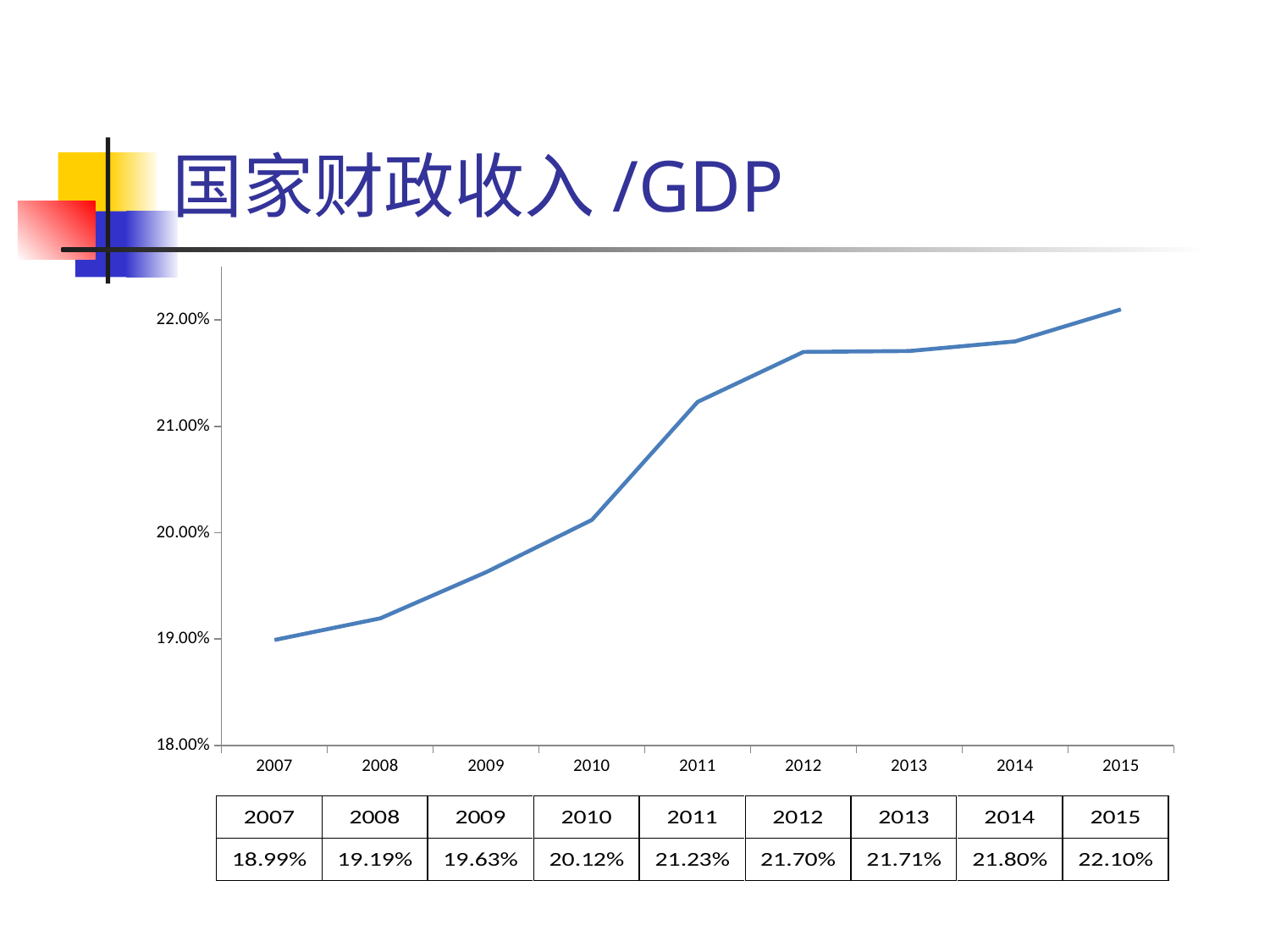
Is the value for 2012 greater or less than 21.00%? greater Do the values rise or fall from 2007 to 2015? rise What is the difference between the values for 2011 and 2010? 1.11% What is the value for 2015? 22.10% Which is larger, the value for 2009 or the value for 2010? 2010 How many years are plotted on the chart? 9 Which year has the lowest value? 2007 What is the value for 2011? 21.23% Which year has the highest value? 2015 What kind of chart is shown on the slide? line chart What is the value for 2007? 18.99% What is the title of the slide? 国家财政收入 /GDP